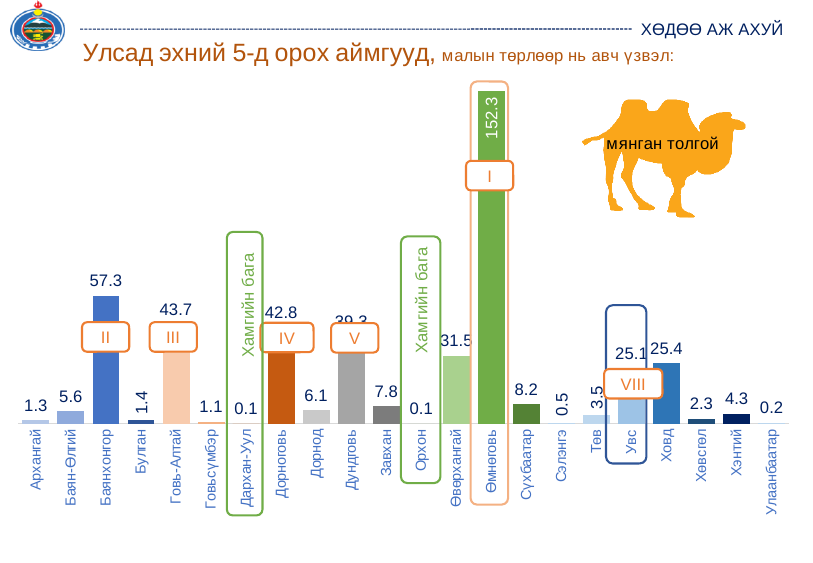
What is the difference between the values for Өмнөговь and Баянхонгор? 95.0 What is the value for Өвөрхангай? 31.5 What is the value for Өмнөговь? 152.3 What is the difference between the values for Баянхонгор and Говь-Алтай? 13.6 What is the value for Сүхбаатар? 8.2 What is the value for Говь-Алтай? 43.7 Which is larger, the value for Дорноговь or the value for Өвөрхангай? Дорноговь What is the value for Баянхонгор? 57.3 How many aimags are shown on the chart? 22 What rank label is shown above the bar for Увс? VIII What kind of chart is shown on the slide? Bar chart Which aimag has the highest value? Өмнөговь